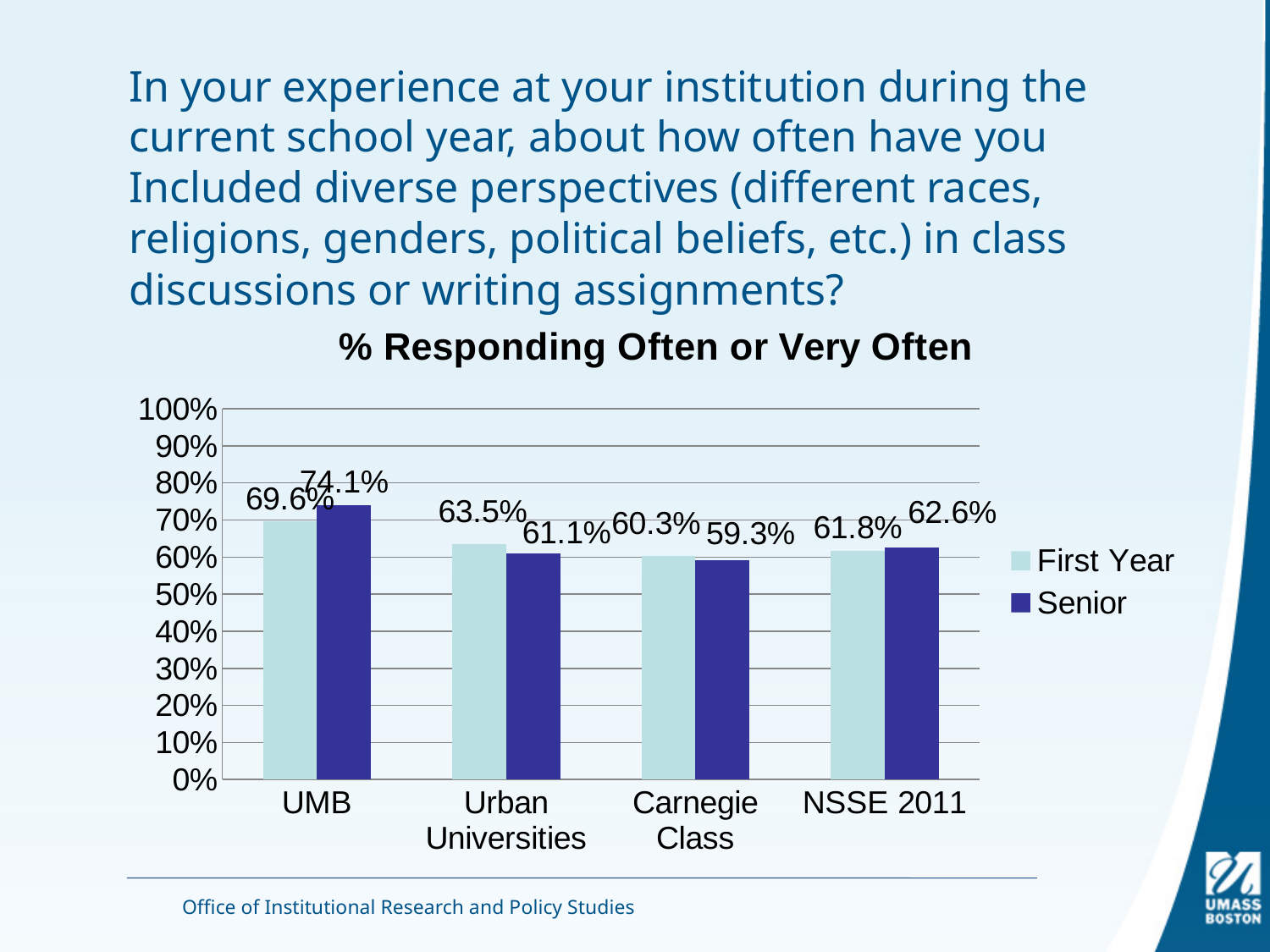
How many categories are shown on the x axis? 4 What is the title of the chart? % Responding Often or Very Often How many series does the legend list? 2 What is the First Year value for UMB? 69.6% What is the difference between the Senior and First Year values for UMB? 4.5% Which is larger for Urban Universities, the First Year value or the Senior value? First Year What is the Senior value for Carnegie Class? 59.3% Which category has the highest Senior value? UMB What kind of chart is shown on the slide? bar chart What is the Senior value for NSSE 2011? 62.6% Is the Senior value for UMB greater or less than 70%? greater Which category has the lowest First Year value? Carnegie Class